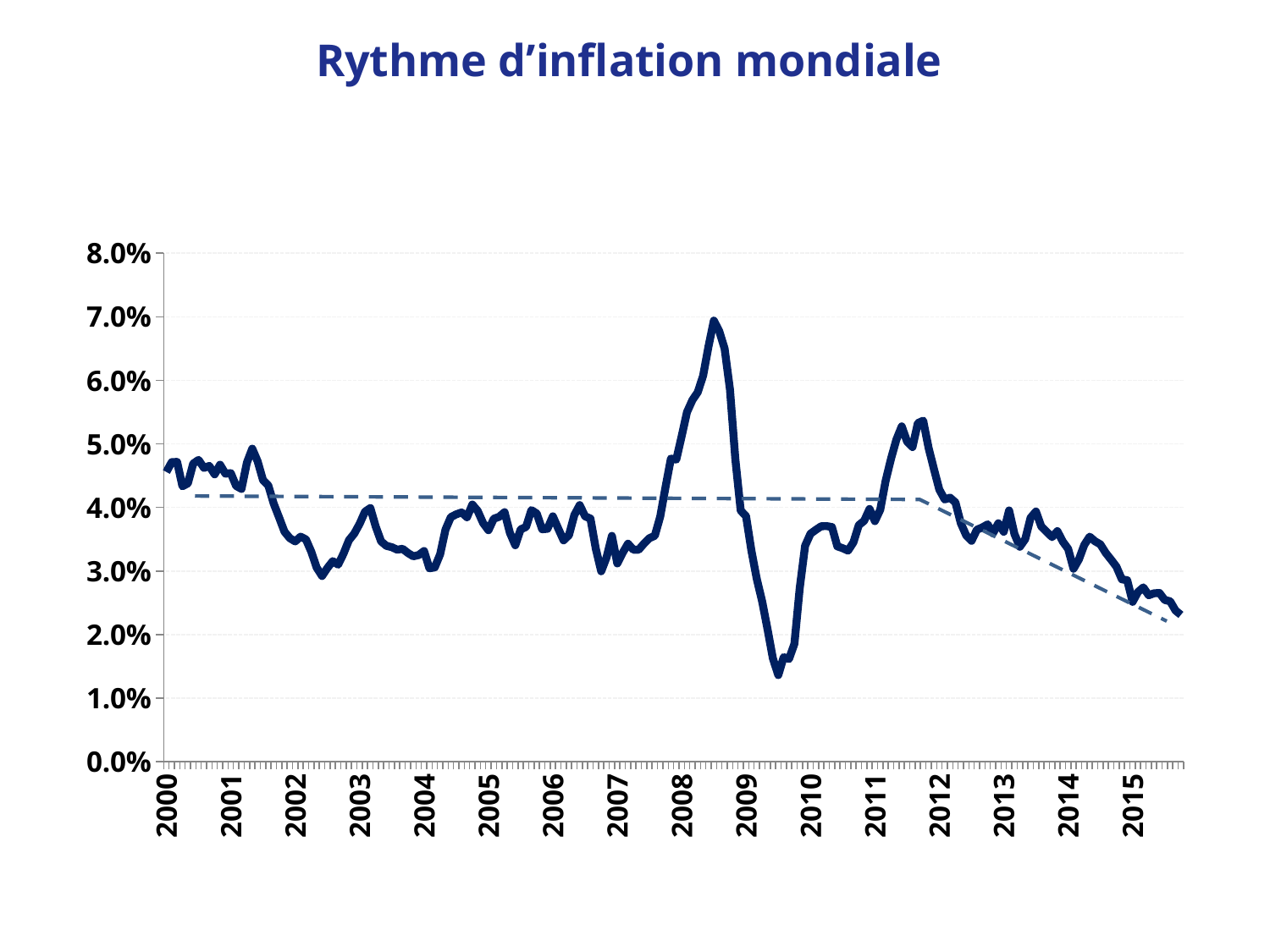
Is the peak of the solid line in 2008 higher or lower than the peak in 2011? higher Is the lowest value of the solid line in 2009 greater or less than 2.0%? less Is the value of the solid line at the end of 2015 greater or less than 3.0%? less Is the value of the solid line at the start of 2000 greater or less than 4.0%? greater Does the solid line rise or fall between 2012 and 2015? fall What is the highest value shown on the y axis? 8.0% What is the title of the chart? Rythme d'inflation mondiale In which year does the solid line reach its highest peak? 2008 How many year labels are shown on the x axis? 16 What kind of chart is shown on the slide? line chart In which year does the solid line reach its lowest point? 2009